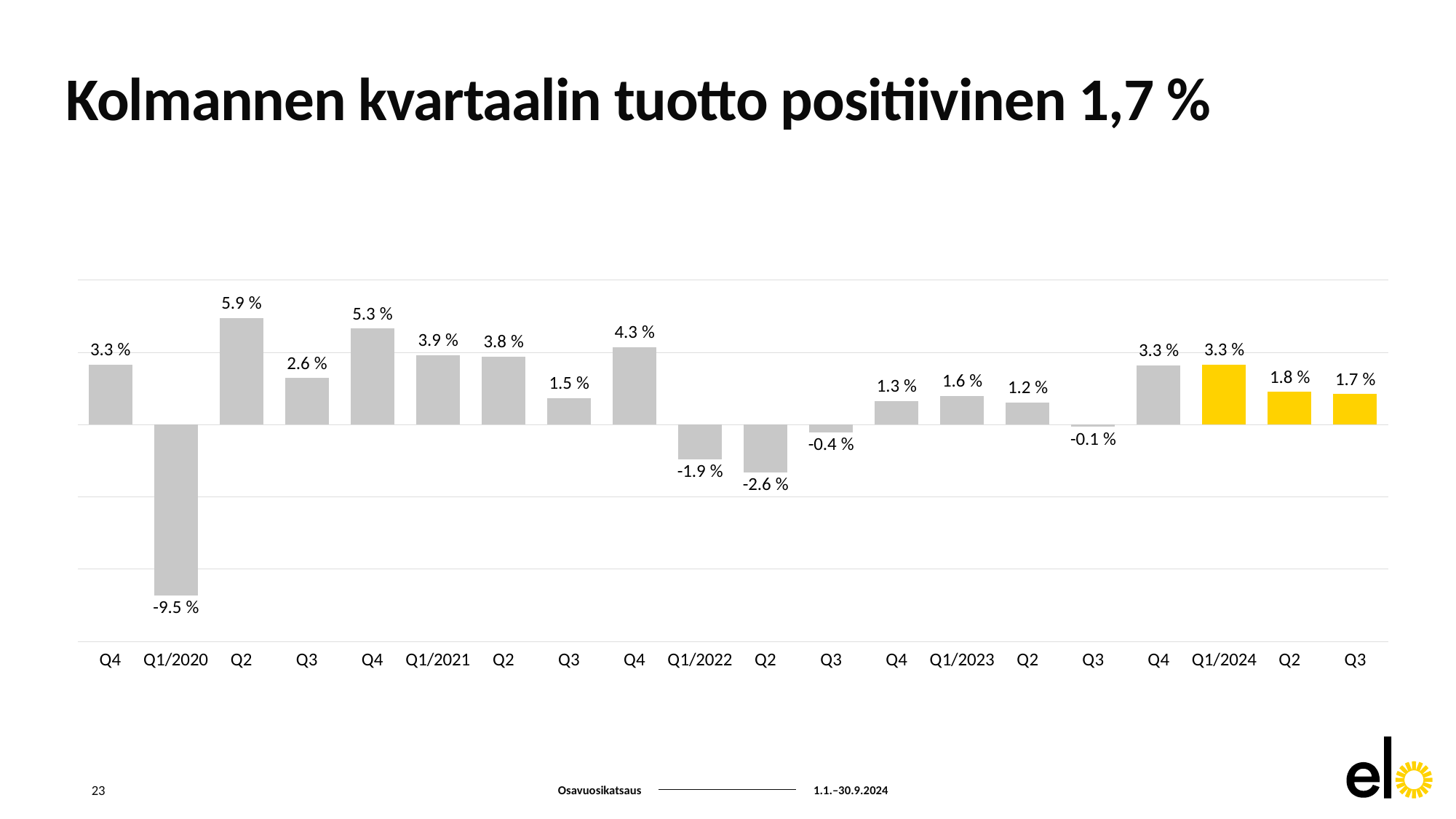
What is the value for Q1/2020? -9.5 % What is the difference between the values for Q1/2024 and Q3 2024? 1.6 % Which is larger, the value for Q4 2021 or the value for Q1/2021? Q4 2021 (4.3 %) How many bars are highlighted in yellow? 3 What kind of chart is shown on the slide? Bar chart Which quarter has the lowest value on the chart? Q1/2020 (-9.5 %) How many quarterly bars are plotted on the chart? 20 What is the title of the slide? Kolmannen kvartaalin tuotto positiivinen 1,7 % What is the value for Q1/2022? -1.9 % Which quarter has the highest value on the chart? Q2 2020 (5.9 %) What is the value for Q3 2024, the last bar on the chart? 1.7 % What is the value for Q1/2023? 1.6 %